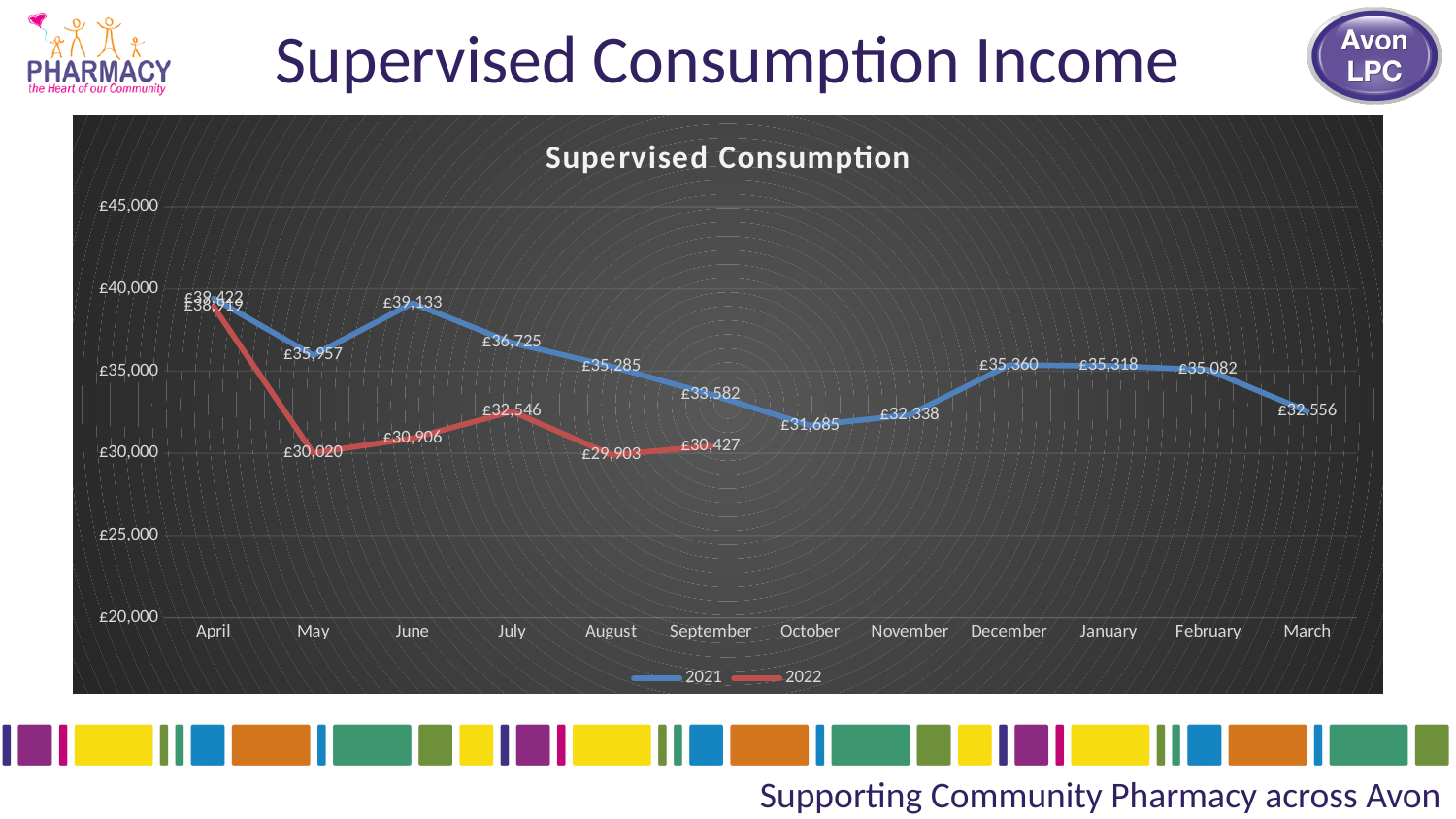
What is the 2021 value for June? £39,133 What is the 2022 value for August? £29,903 Which series has the larger value in September, 2021 or 2022? 2021 Is the 2021 value for March greater or less than £35,000? less What is the 2021 value for December? £35,360 How many series does the legend list? 2 Do the 2021 values rise or fall from June to October? fall What is the difference between the 2021 and 2022 values for July? £4,179 Which month has the lowest 2022 value? August How many months are shown along the x axis? 12 Which month has the lowest 2021 value? October What kind of chart is shown on the slide? Line chart